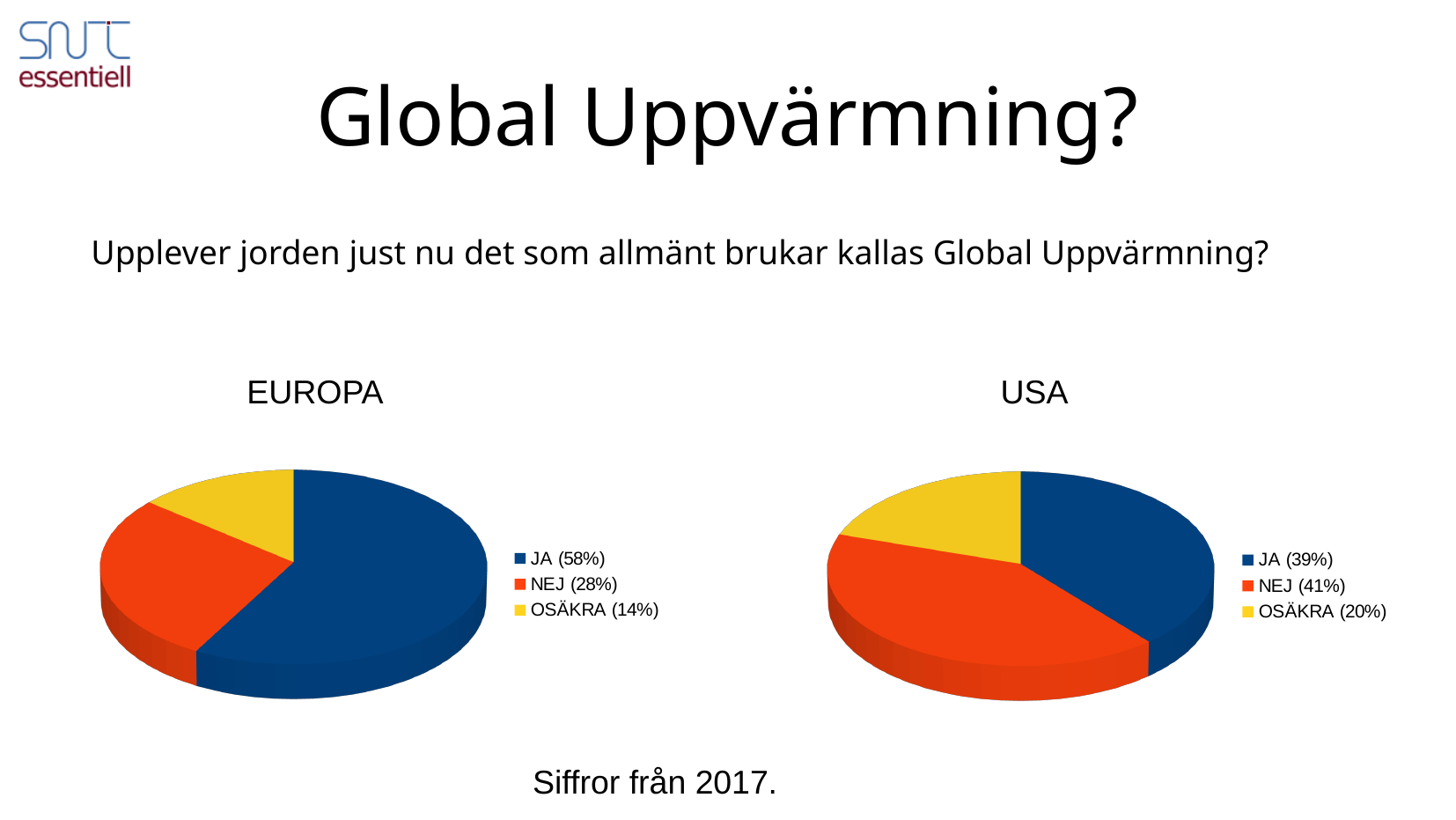
In the USA chart, what is the difference between the NEJ and OSÄKRA shares? 21% What kind of chart is the USA chart? Pie chart In the USA chart, what colour is the NEJ slice? Red In the EUROPA chart, which category has the largest slice? JA In the USA chart, what share of respondents answered OSÄKRA? 20% What year are the figures on the slide from? 2017 In the EUROPA chart, what is the difference between the JA and NEJ shares? 30% In the EUROPA chart, what share of respondents answered JA? 58% Which chart has the larger JA share, EUROPA or USA? EUROPA In the USA chart, which category has the smallest slice? OSÄKRA In the USA chart, what share of respondents answered NEJ? 41% In the EUROPA chart, how many categories are shown? 3